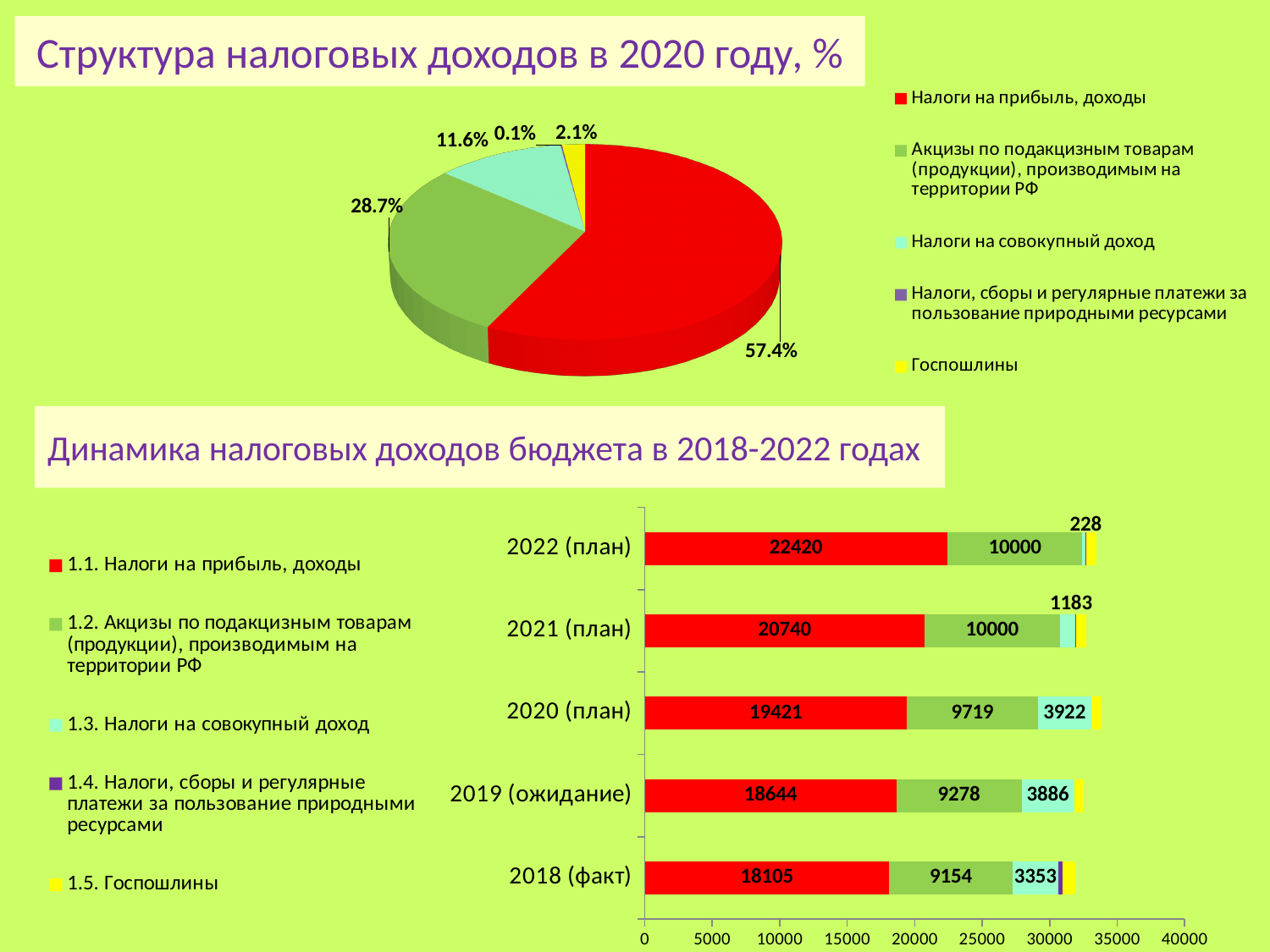
In the chart 'Динамика налоговых доходов бюджета в 2018-2022 годах', how many series does the legend list? 5 In the chart 'Динамика налоговых доходов бюджета в 2018-2022 годах', what is the difference between '1.1. Налоги на прибыль, доходы' in 2022 (план) and 2018 (факт)? 4315 In the pie chart 'Структура налоговых доходов в 2020 году, %', what is the value for 'Госпошлины'? 2.1% In the chart 'Динамика налоговых доходов бюджета в 2018-2022 годах', what is the value of '1.2. Акцизы по подакцизным товарам' for 2018 (факт)? 9154 In the pie chart 'Структура налоговых доходов в 2020 году, %', which category has the smallest slice? Налоги, сборы и регулярные платежи за пользование природными ресурсами In the pie chart 'Структура налоговых доходов в 2020 году, %', how many slices are there? 5 In the chart 'Динамика налоговых доходов бюджета в 2018-2022 годах', what is the value of '1.1. Налоги на прибыль, доходы' for 2020 (план)? 19421 In the chart 'Динамика налоговых доходов бюджета в 2018-2022 годах', which year has the highest value for '1.1. Налоги на прибыль, доходы'? 2022 (план) In the pie chart 'Структура налоговых доходов в 2020 году, %', what share do 'Налоги на прибыль, доходы' have? 57.4% In the chart 'Динамика налоговых доходов бюджета в 2018-2022 годах', does the value of '1.1. Налоги на прибыль, доходы' rise or fall from 2018 (факт) to 2022 (план)? Rise What type of chart is 'Динамика налоговых доходов бюджета в 2018-2022 годах'? Stacked bar chart In the pie chart 'Структура налоговых доходов в 2020 году, %', what is the difference between the shares of 'Акцизы по подакцизным товарам' and 'Налоги на совокупный доход'? 17.1%